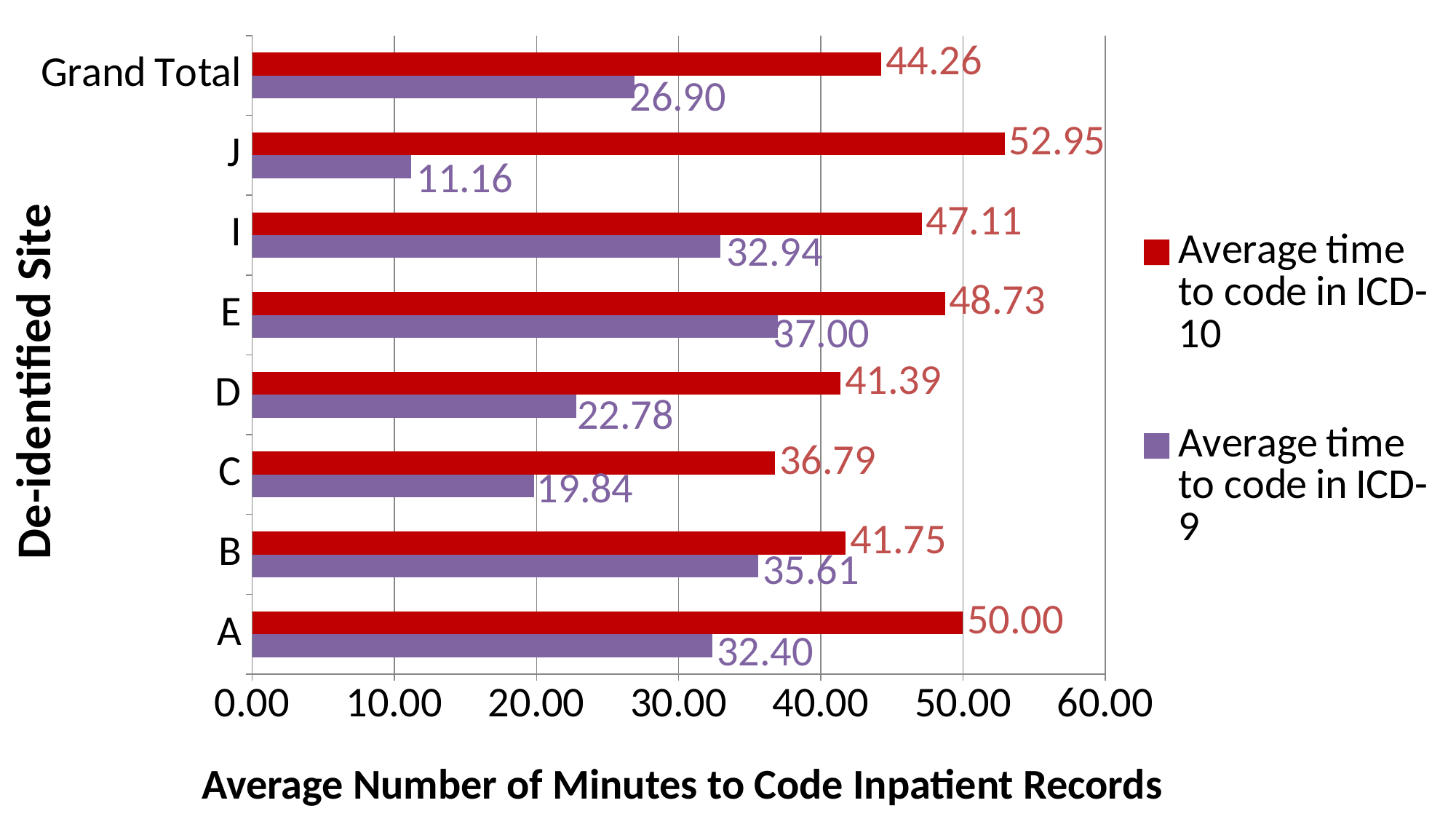
How many categories are shown on the vertical axis, including Grand Total? 8 What is the average time to code in ICD-9 for site C? 19.84 What is the Grand Total average time to code in ICD-9? 26.90 What is the label of the horizontal axis? Average Number of Minutes to Code Inpatient Records What is the average time to code in ICD-10 for site J? 52.95 Is the ICD-10 average time for site C greater or less than 40.00? less Which site has the lowest average time to code in ICD-9? J Which is larger: the ICD-9 average time for site E or for site B? Site E What kind of chart is shown on the slide? Bar chart What is the difference between the ICD-10 and ICD-9 average coding times for site A? 17.60 Which site has the highest average time to code in ICD-10? J How many series does the legend list? 2